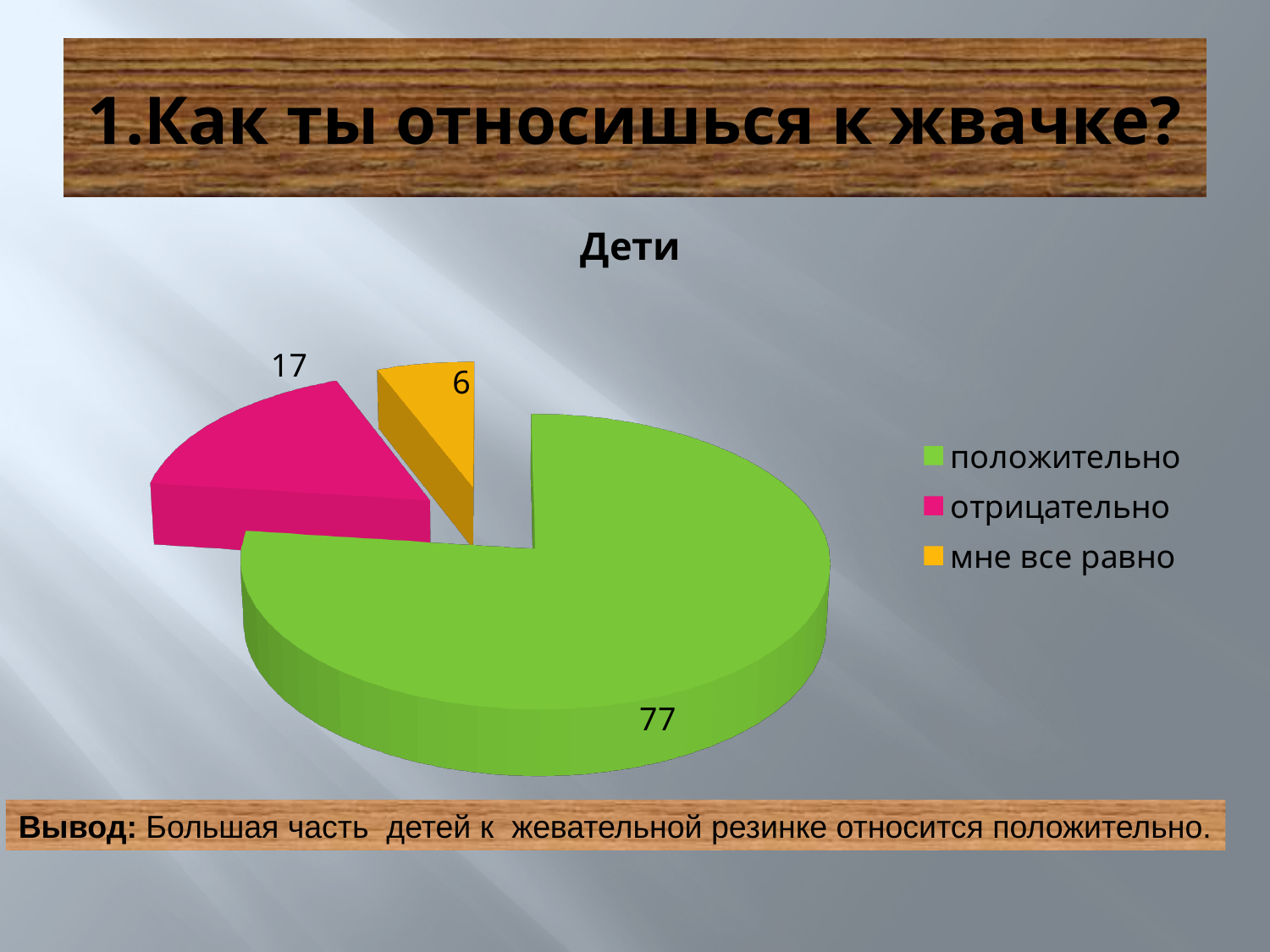
What is the value for положительно in the pie chart? 77 What is the value for отрицательно in the pie chart? 17 Which is larger, the value for отрицательно or the value for мне все равно? отрицательно What share of the pie does the положительно slice represent? 77% What is the difference between the values for отрицательно and мне все равно? 11 How many slices does the pie chart have? 3 What is the value for мне все равно in the pie chart? 6 Which category has the largest slice in the pie chart? положительно Which category has the smallest slice in the pie chart? мне все равно What kind of chart is shown on the slide? pie chart What is the title of the chart? Дети What is the difference between the values for положительно and отрицательно? 60